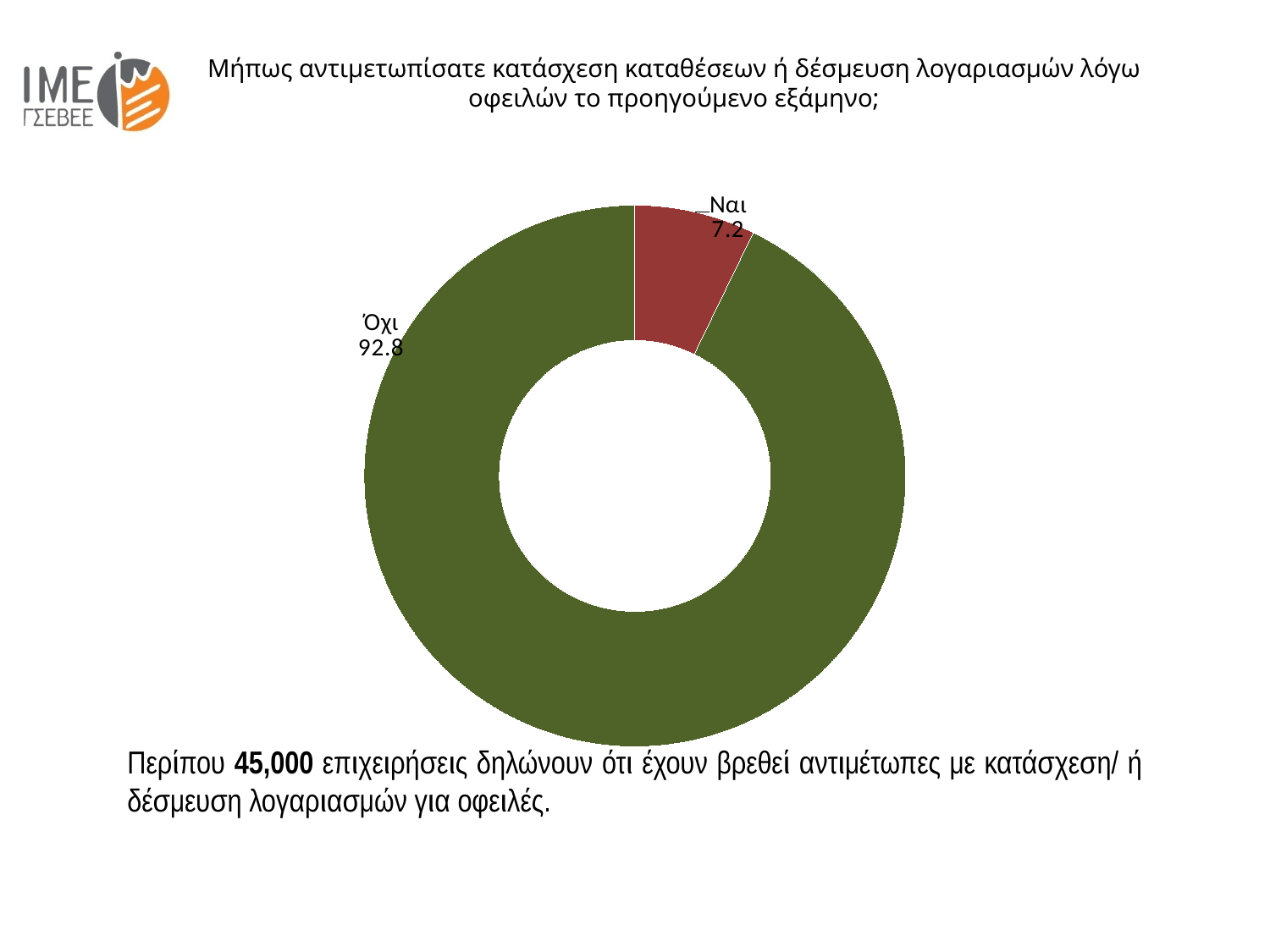
What is the difference between the values for "Όχι" and "Ναι"? 85.6 What kind of chart is shown on the slide? Doughnut (pie) chart What is the total of the two values shown in the chart? 100 What is the value shown for the "Όχι" slice? 92.8 What colour is the "Όχι" slice? Green Which is larger, the value for "Ναι" or the value for "Όχι"? Όχι What is the value shown for the "Ναι" slice? 7.2 Which category has the smallest slice? Ναι What colour is the "Ναι" slice? Red How many categories are shown in the chart? 2 Which category has the largest slice? Όχι